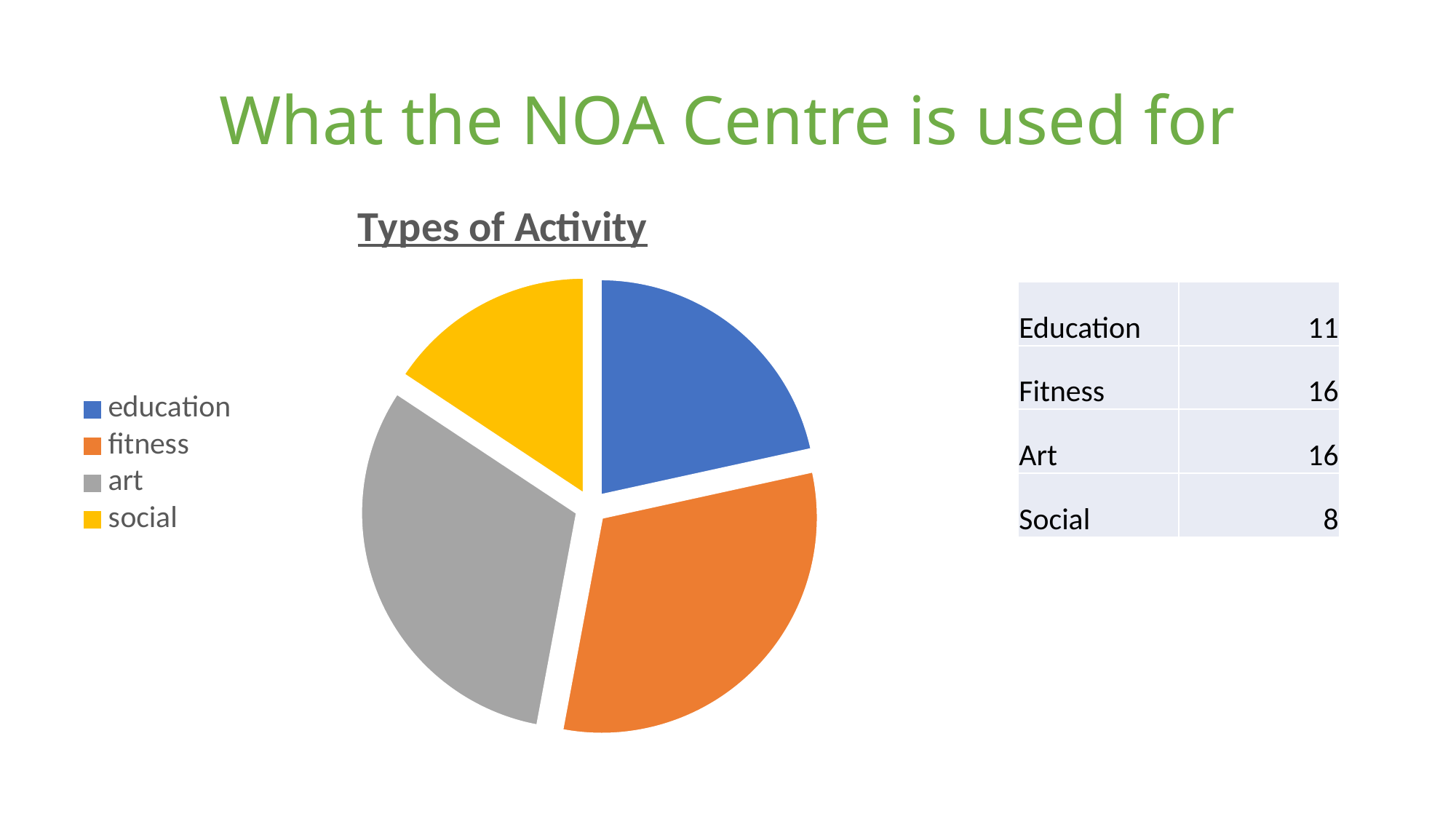
What is the difference between the values for Art and Social? 8 How many slices does the pie chart have? 4 What is the value for Art? 16 Which is larger, the value for Fitness or the value for Education? Fitness What is the value for Education? 11 What type of chart is shown on the slide? pie chart What is the value for Social? 8 Which colour represents social in the pie chart? yellow What is the value for Fitness? 16 What is the difference between the values for Fitness and Education? 5 What is the title of the chart? Types of Activity Which activity type has the smallest slice of the pie? social